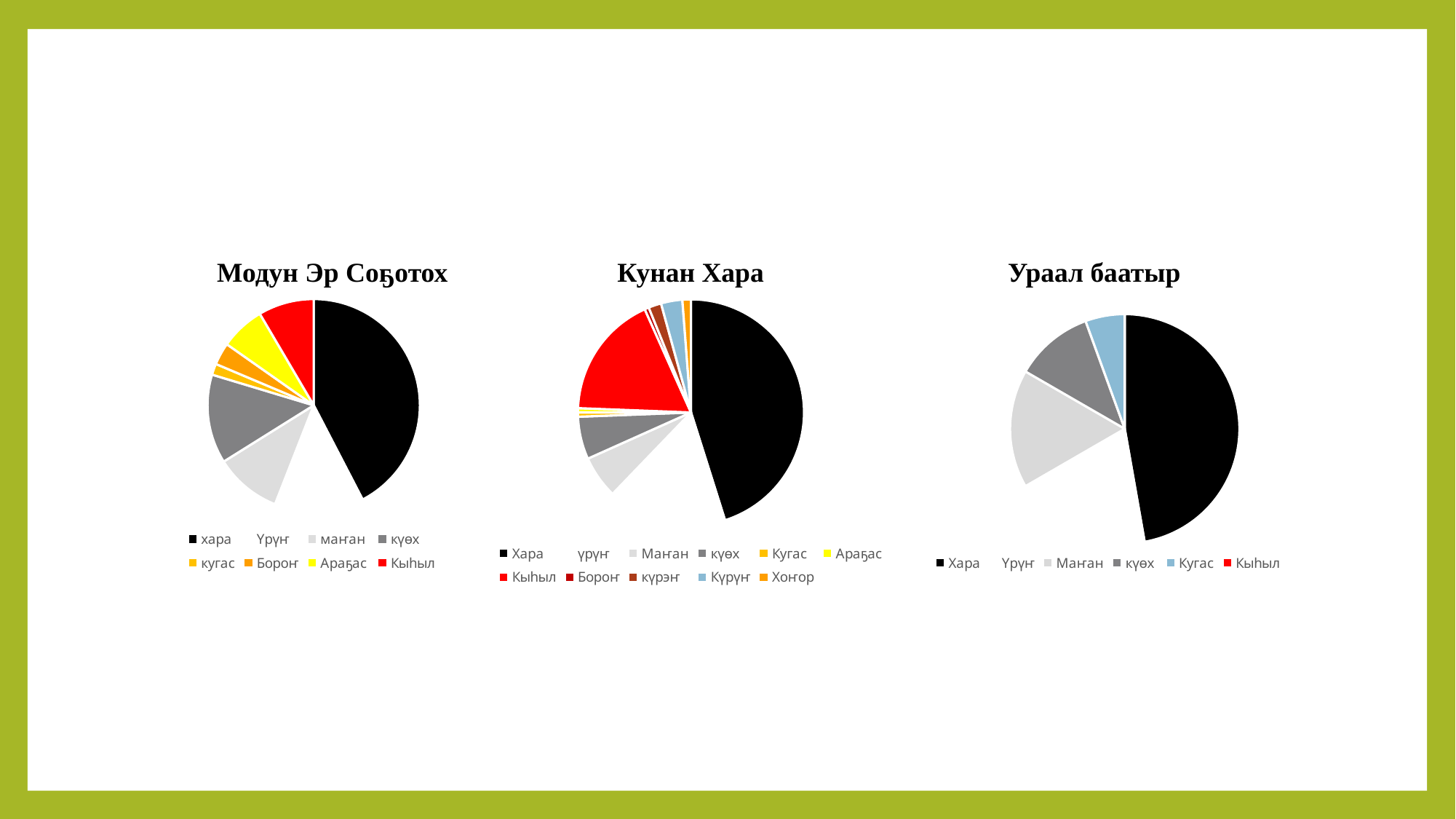
In the chart titled "Модун Эр Соҕотох", which category has the largest slice? хара What kind of chart is the chart titled "Модун Эр Соҕотох"? pie chart In the chart titled "Ураал баатыр", which slice is larger, Маҥан or Кугас? Маҥан How many categories does the legend of the chart titled "Модун Эр Соҕотох" list? 8 In the chart titled "Модун Эр Соҕотох", which slice is larger, күөх or Араҕас? күөх What is the title of the rightmost chart on the slide? Ураал баатыр In the chart titled "Кунан Хара", which category has the largest slice? Хара In the chart titled "Кунан Хара", which slice is larger, Хара or Кыһыл? Хара How many categories does the legend of the chart titled "Кунан Хара" list? 11 How many pie charts are shown on the slide? 3 In the chart titled "Ураал баатыр", which category has the largest slice? Хара How many categories does the legend of the chart titled "Ураал баатыр" list? 6